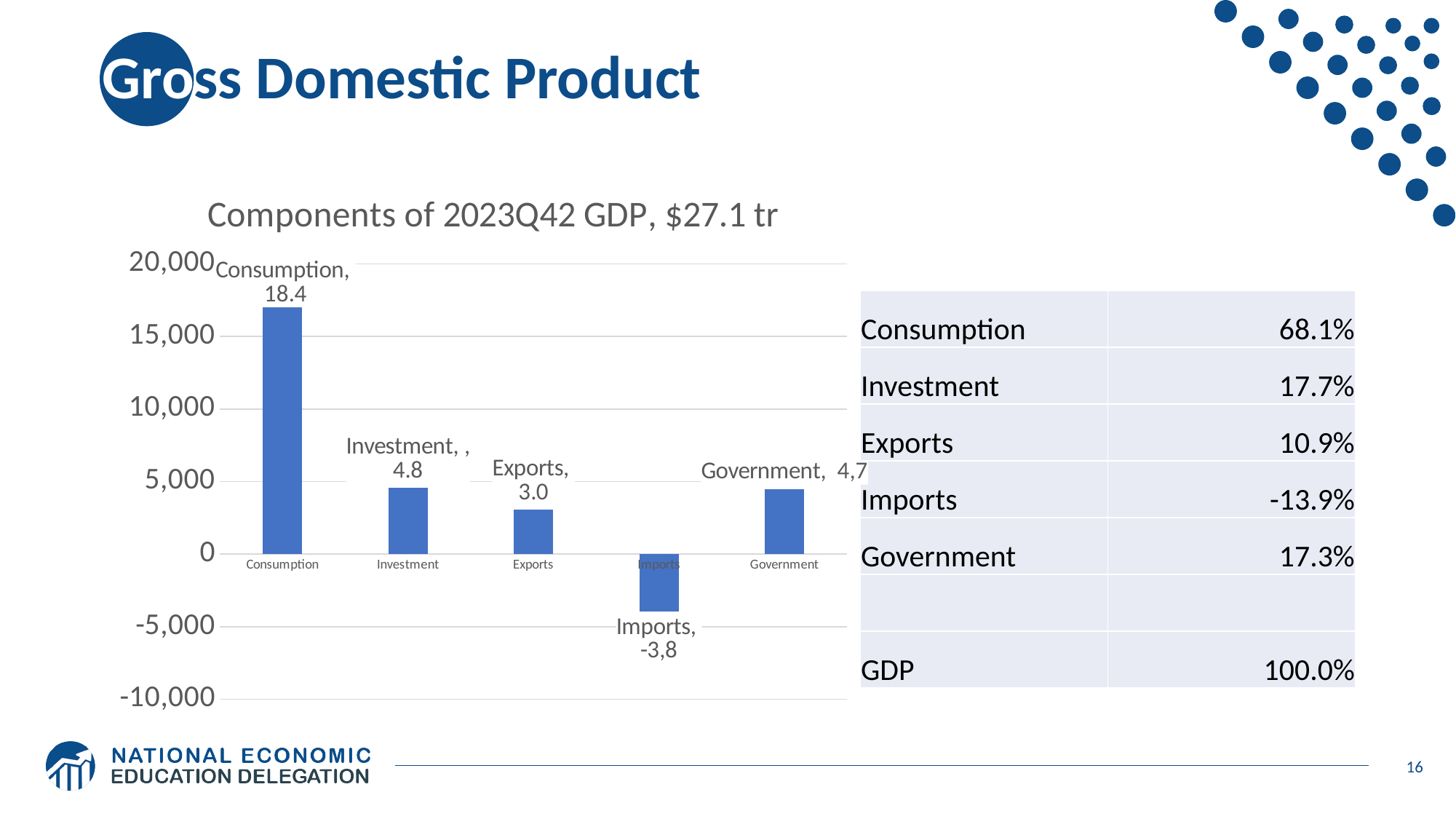
What is the title of the chart? Components of 2023Q42 GDP, $27.1 tr Is the bar for Consumption greater or less than 15,000 on the axis? greater What is the data label value for Government in the chart? 4,7 What is the data label value for Exports in the chart? 3.0 What is the data label value for Consumption in the chart? 18.4 How many components (bars) are plotted in the chart? 5 What kind of chart is shown on the slide? Bar chart Which component has the lowest bar in the chart? Imports What is the data label value for Imports in the chart? -3,8 Which is larger, the bar for Consumption or the bar for Exports? Consumption Which component has the highest bar in the chart? Consumption What is the data label value for Investment in the chart? 4.8